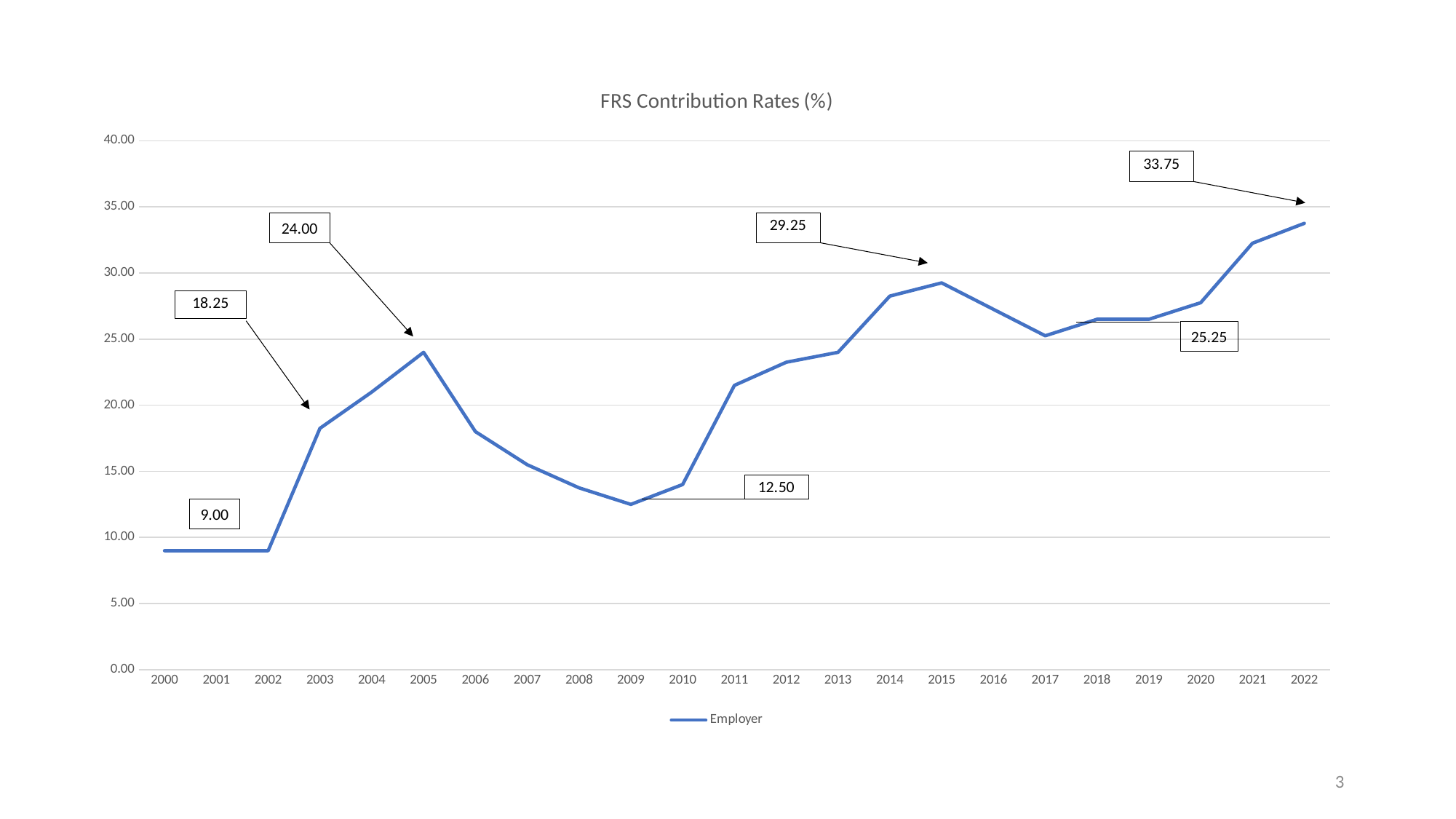
How many years are shown on the x axis? 23 Which is larger, the Employer rate in 2005 or the rate in 2017? 2017 What is the title of the chart? FRS Contribution Rates (%) Which year has the highest Employer contribution rate? 2022 What is the Employer contribution rate in 2009? 12.50 What is the Employer contribution rate in 2003? 18.25 What is the difference between the Employer rate in 2022 and the rate in 2015? 4.50 What is the Employer contribution rate in 2022? 33.75 What is the Employer contribution rate in 2005? 24.00 What type of chart is shown on the slide? line chart How many series does the legend list? 1 Is the Employer contribution rate in 2014 greater or less than 25.00? greater